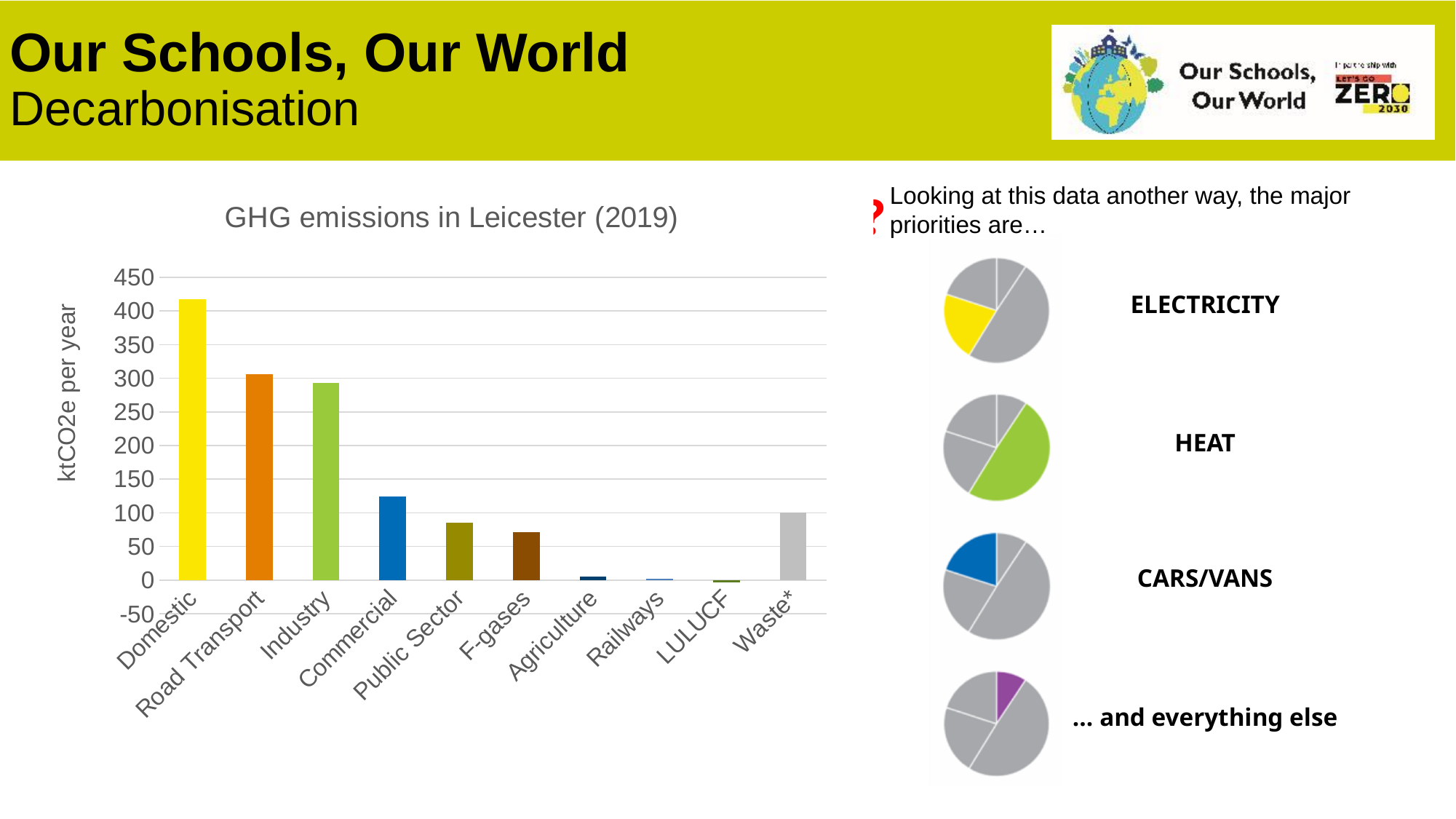
In the 'GHG emissions in Leicester (2019)' chart, is the value for Domestic greater or less than 400? greater What kind of chart is 'GHG emissions in Leicester (2019)'? bar chart In the 'GHG emissions in Leicester (2019)' chart, which is larger: Waste* or Public Sector? Waste* In the 'GHG emissions in Leicester (2019)' chart, is the value for Public Sector greater or less than 100? less How many categories are shown on the x axis of the 'GHG emissions in Leicester (2019)' chart? 10 What is the y-axis label of the 'GHG emissions in Leicester (2019)' chart? ktCO2e per year In the 'GHG emissions in Leicester (2019)' chart, is the value for Waste* greater or less than 50? greater In the 'GHG emissions in Leicester (2019)' chart, which is larger: Road Transport or Commercial? Road Transport In the 'GHG emissions in Leicester (2019)' chart, which category has the highest emissions? Domestic How many small pie charts are shown on the right side of the slide? 4